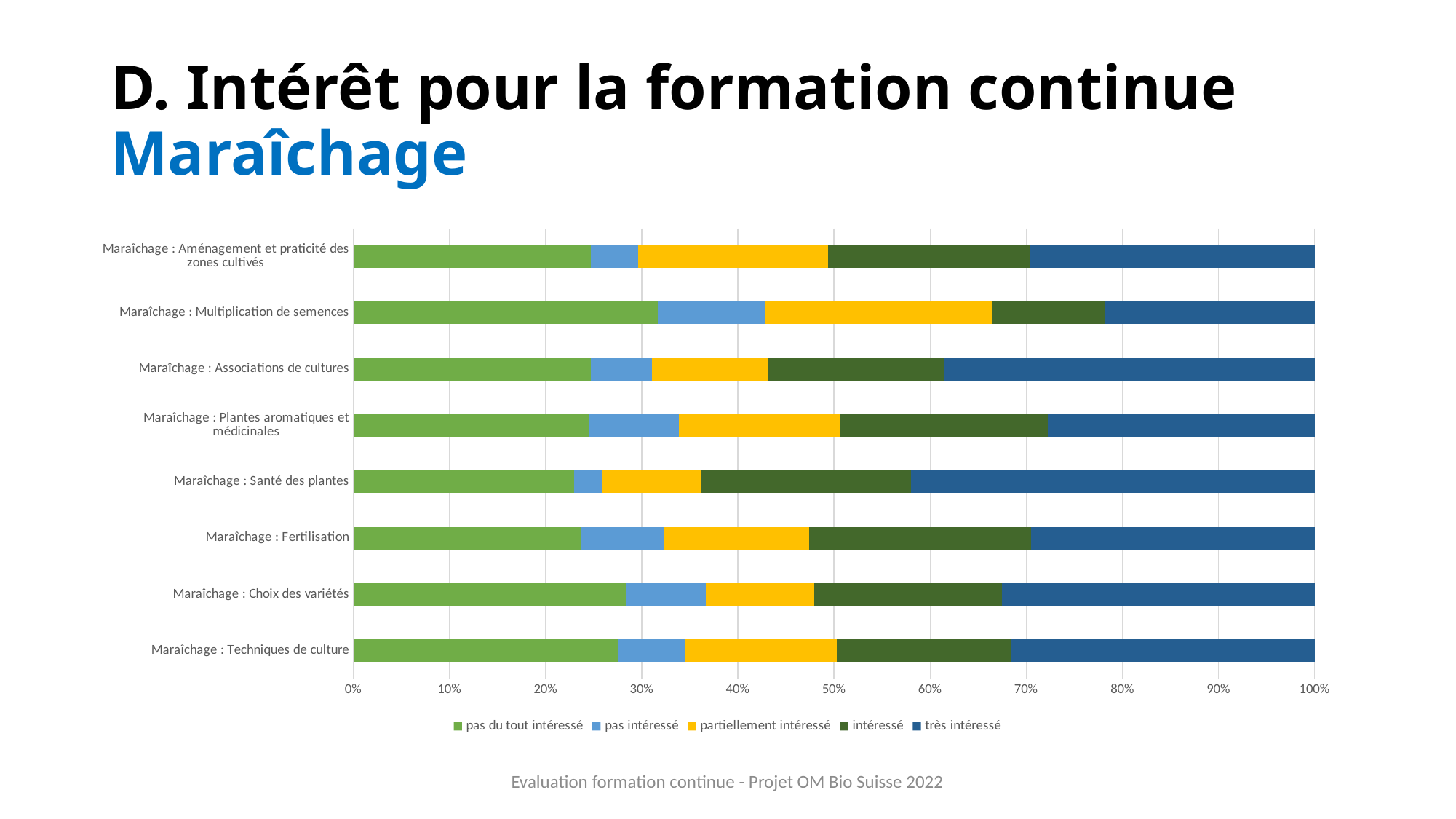
Which category has the smallest 'très intéressé' share? Maraîchage : Multiplication de semences Which category has the largest 'pas du tout intéressé' share? Maraîchage : Multiplication de semences Which category has the largest 'très intéressé' share? Maraîchage : Santé des plantes Is the 'pas du tout intéressé' share for Maraîchage : Multiplication de semences greater or less than 30%? greater Is the 'pas du tout intéressé' share for Maraîchage : Santé des plantes greater or less than 30%? less How many categories (training topics) are plotted on the chart? 8 Which series is listed first in the legend? pas du tout intéressé Which has the larger 'très intéressé' share: Maraîchage : Santé des plantes or Maraîchage : Multiplication de semences? Maraîchage : Santé des plantes How many series does the legend list? 5 What is the highest value shown on the horizontal axis? 100% What kind of chart is shown on the slide? Stacked bar chart Is the 'très intéressé' share for Maraîchage : Santé des plantes greater or less than 40%? greater